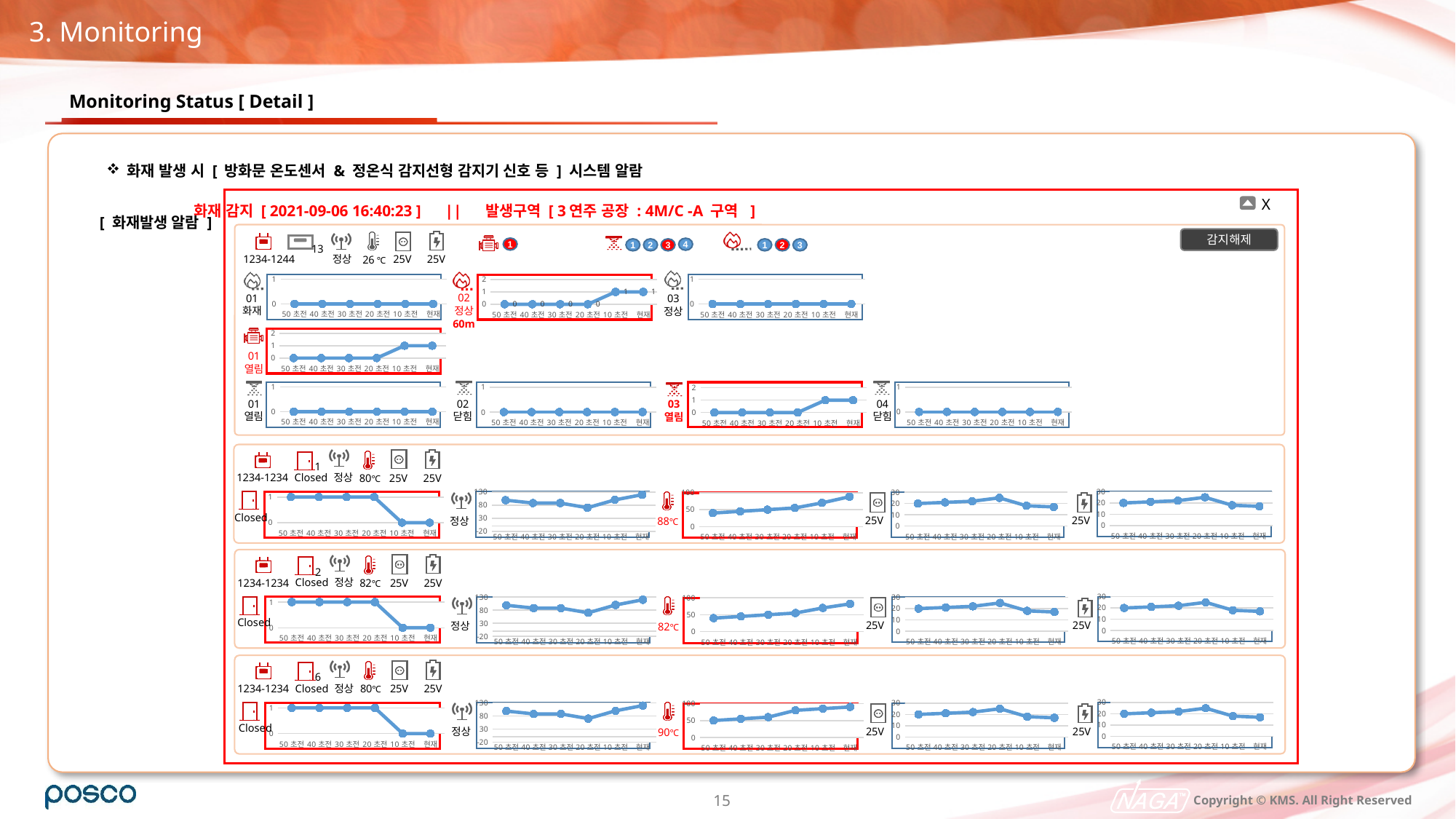
In the top section, what is the value at 현재 on the '02' fire detector chart labelled 60m? 1 In the second section (1234-1234, 80℃), is the 현재 value of the temperature chart labelled 88℃ greater or less than 50? greater In the top section, does the '03 열림' sprinkler chart rise or fall from 50 초전 to 현재? rise In the second section (1234-1234, 80℃), is the 50 초전 value of the temperature chart labelled 88℃ greater or less than 50? less In the top section, what is the value at 50 초전 on the '01 열림' chart? 0 What is the label of the rightmost point on the x axis of the charts? 현재 In the third section (1234-1234, 82℃), does the temperature chart labelled 82℃ rise or fall from 50 초전 to 현재? rise How many time points are plotted along the x axis of the '01 열림' chart in the top section? 6 What kind of chart is the '01 화재' chart in the top section of the dashboard? line chart In the top section, what is the value at 현재 on the '01 화재' chart? 0 In the second section (1234-1234, 80℃), does the Closed door chart rise or fall from 50 초전 to 현재? fall